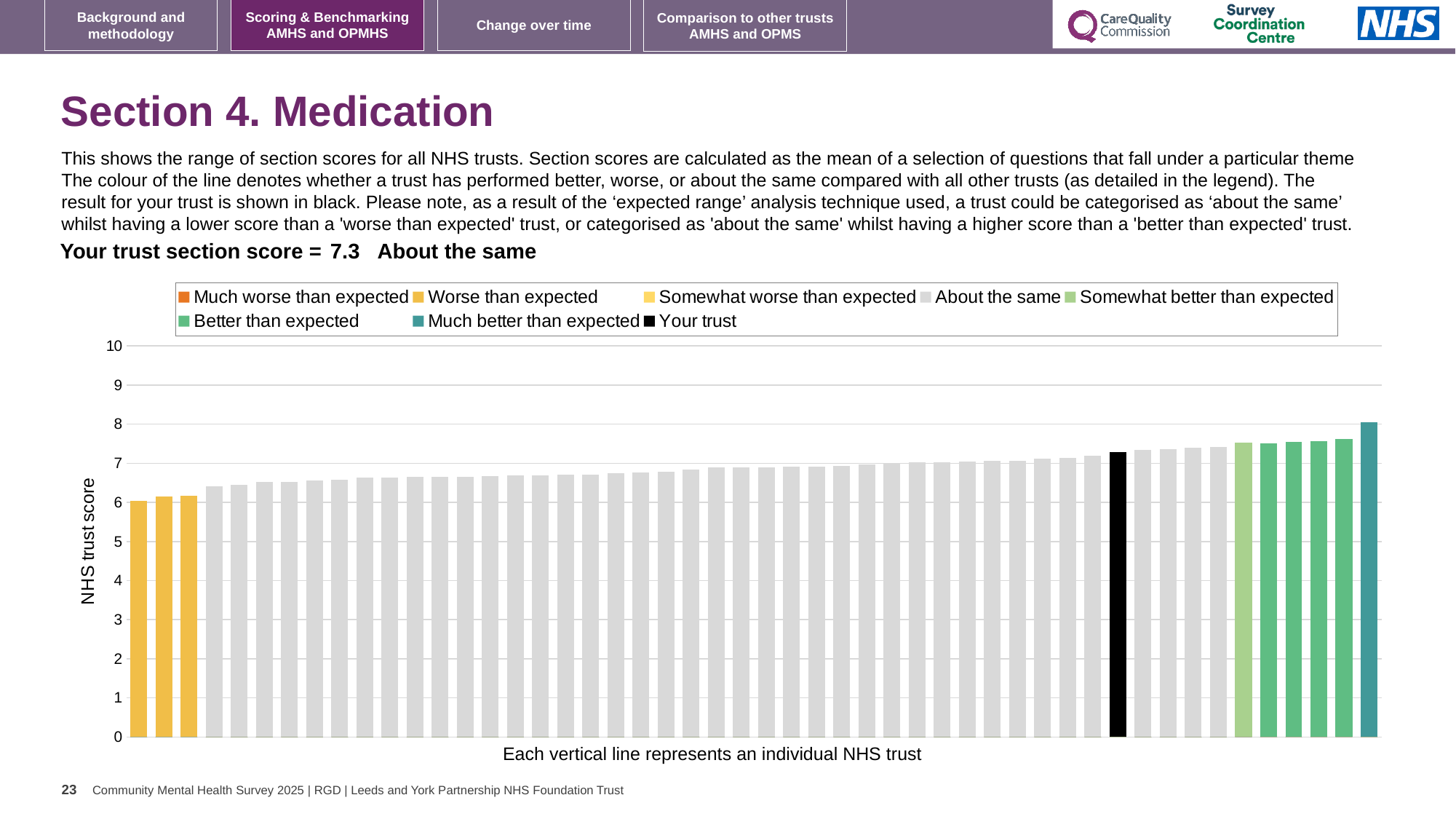
Is the bar for your trust taller or shorter than the tallest 'Worse than expected' bar? taller How many bars are coloured as 'Worse than expected'? 3 What kind of chart is shown on the slide? bar chart Is the value for your trust (the black bar) greater or less than 7? greater Do the bar values rise or fall from left to right along the x axis? rise What is the section score for your trust shown on the slide? 7.3 How many entries does the chart legend list? 8 What is the label on the vertical axis of the chart? NHS trust score Which legend category does the shortest bar belong to? Worse than expected Is the value of the shortest bar greater or less than 7? less Which legend category does the tallest bar belong to? Much better than expected Is the value of the shortest bar greater or less than 5? greater